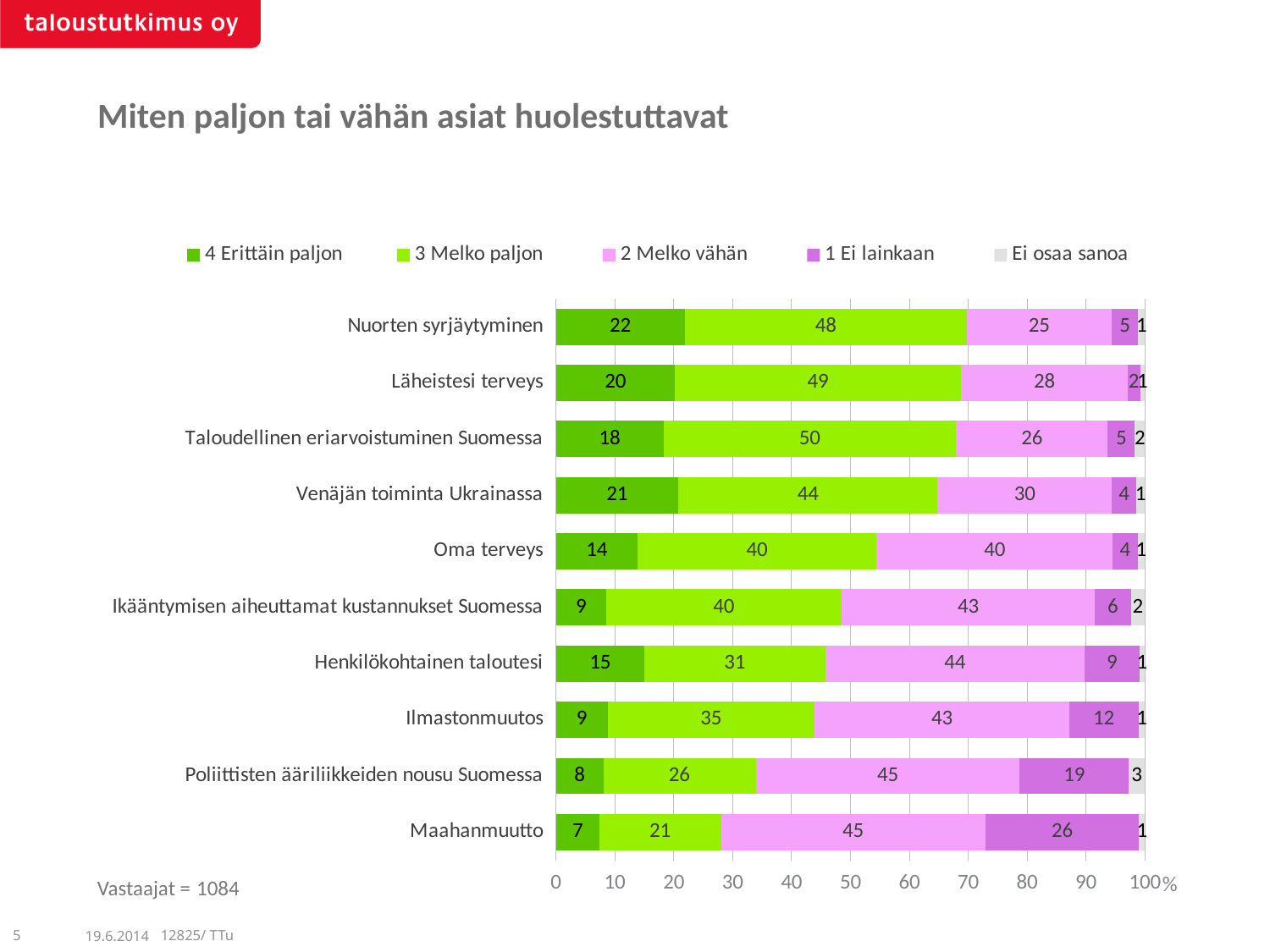
What is the value of "2 Melko vähän" for Oma terveys? 40 What is the value of "1 Ei lainkaan" for Maahanmuutto? 26 How many categories are shown in the chart? 10 Which category has the lowest value for "4 Erittäin paljon"? Maahanmuutto Which category has the highest value for "4 Erittäin paljon"? Nuorten syrjäytyminen Which has a larger "1 Ei lainkaan" value: Ilmastonmuutos or Poliittisten ääriliikkeiden nousu Suomessa? Poliittisten ääriliikkeiden nousu Suomessa What is the total of the stacked bar for Henkilökohtainen taloutesi? 100 What is the value of "4 Erittäin paljon" for Nuorten syrjäytyminen? 22 What kind of chart is shown on the slide? Stacked bar chart What is the difference between the "3 Melko paljon" values for Läheistesi terveys and Maahanmuutto? 28 What is the value of "3 Melko paljon" for Taloudellinen eriarvoistuminen Suomessa? 50 How many series does the legend list? 5